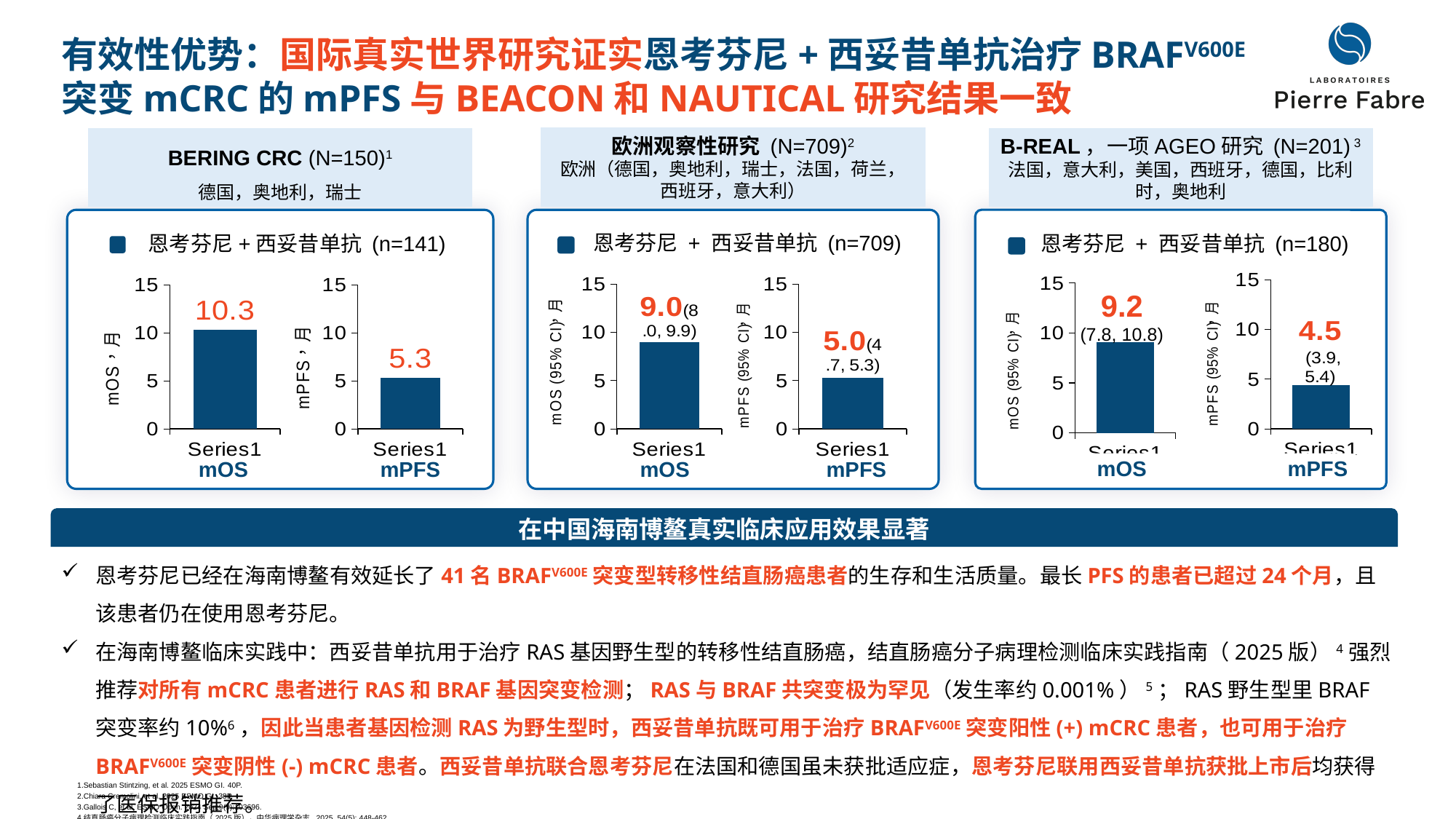
In the BERING CRC panel, what is the mPFS value shown on the mPFS chart? 5.3 In the B-REAL panel, what is the mOS value shown on the mOS chart? 9.2 What is the maximum value shown on the y axis of the mOS chart in the B-REAL panel? 15 What kind of chart is used to show mOS in the BERING CRC panel? bar chart In the BERING CRC panel, what is the mOS value shown on the mOS chart? 10.3 In the B-REAL panel, is the mPFS value greater or less than 5? less In the BERING CRC panel, what is the difference between the mOS value and the mPFS value? 5.0 In the 欧洲观察性研究 panel, what is the mOS value shown on the mOS chart? 9.0 How many bars are plotted on the mPFS chart in the 欧洲观察性研究 panel? 1 In the 欧洲观察性研究 panel, what is the mPFS value shown on the mPFS chart? 5.0 Which is larger: the mOS value in the BERING CRC panel or the mOS value in the B-REAL panel? BERING CRC In the B-REAL panel, what is the mPFS value shown on the mPFS chart? 4.5